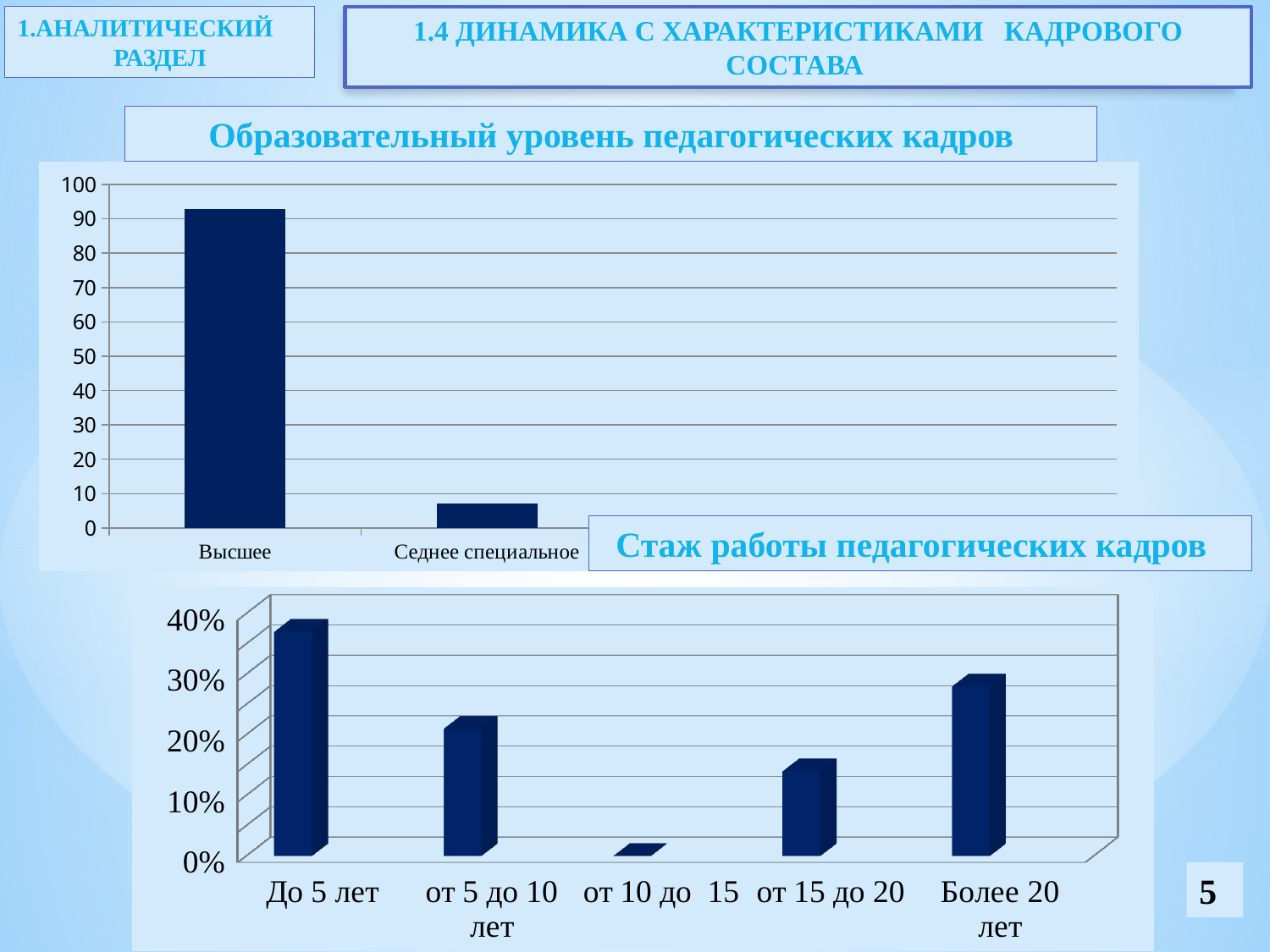
In the 'Стаж работы педагогических кадров' chart, which category has the lowest value? от 10 до 15 In the 'Стаж работы педагогических кадров' chart, which is larger: от 5 до 10 лет or Более 20 лет? Более 20 лет In the 'Образовательный уровень педагогических кадров' chart, is the value for Высшее greater or less than 90? greater What is the title of the lower chart on the slide? Стаж работы педагогических кадров How many categories are shown in the 'Образовательный уровень педагогических кадров' chart? 2 In the 'Стаж работы педагогических кадров' chart, is the value for от 15 до 20 greater or less than 20%? less In the 'Стаж работы педагогических кадров' chart, which category has the highest value? До 5 лет What kind of chart is the 'Образовательный уровень педагогических кадров' chart? bar chart What kind of chart is the 'Стаж работы педагогических кадров' chart? bar chart How many categories are shown in the 'Стаж работы педагогических кадров' chart? 5 In the 'Образовательный уровень педагогических кадров' chart, is the value for Седнее специальное greater or less than 10? less In the 'Образовательный уровень педагогических кадров' chart, which category has the highest value? Высшее